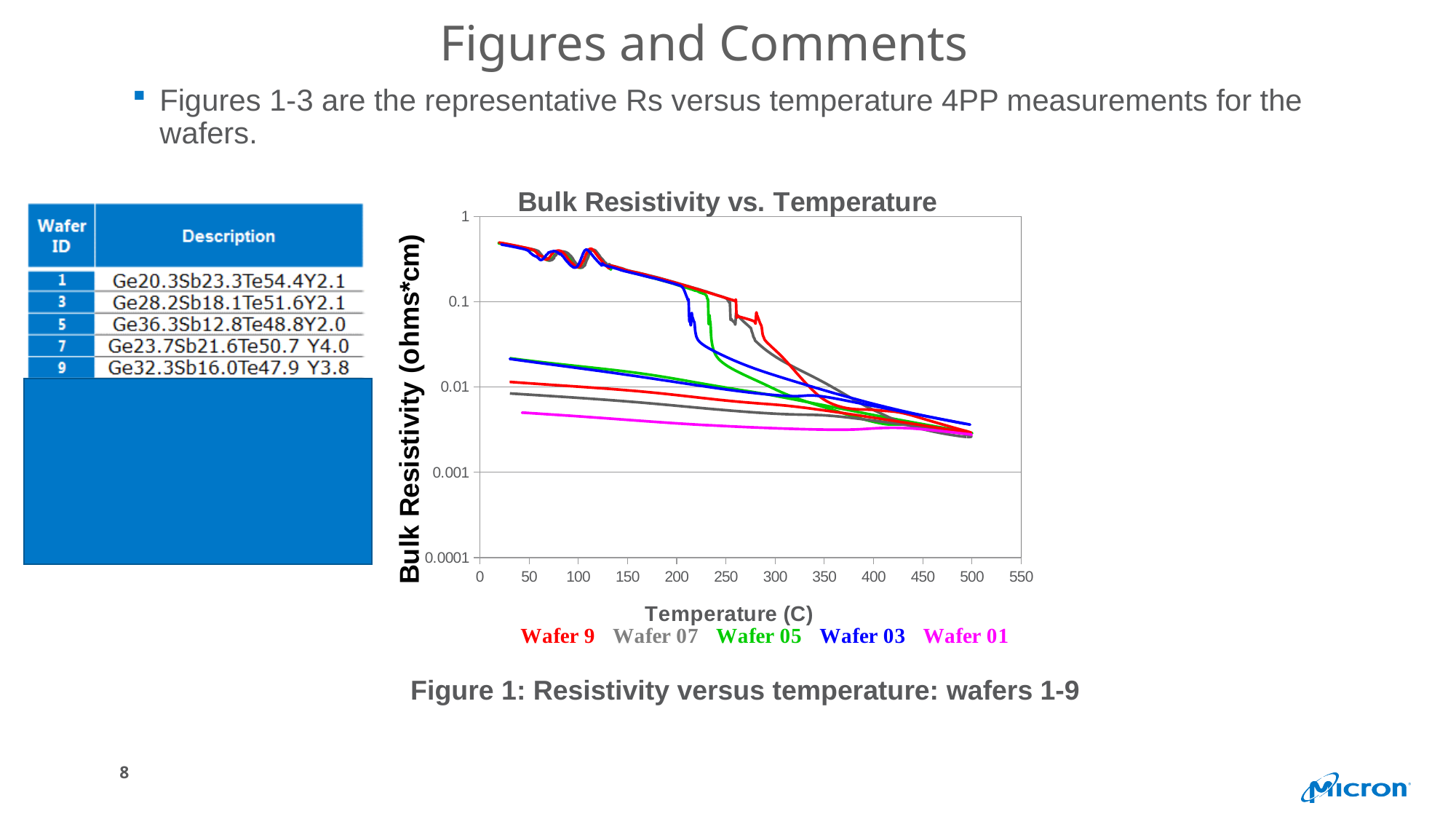
What is the title of the chart on the slide? Bulk Resistivity vs. Temperature What is the smallest tick value shown on the y axis? 0.0001 Is the resistivity of Wafer 01 at 300 C greater or less than 0.001? greater Overall, do the resistivity values rise or fall as temperature increases along the x axis? fall Is the highest resistivity value plotted at 50 C greater or less than 0.1? greater Which wafer has the lowest resistivity at 100 C? Wafer 01 How many series does the legend of the Bulk Resistivity vs. Temperature chart list? 5 Which series is drawn in magenta in the legend? Wafer 01 What is the largest tick value shown on the x axis? 550 What kind of chart is shown on the slide? line chart What is the label of the x axis of the chart? Temperature (C)